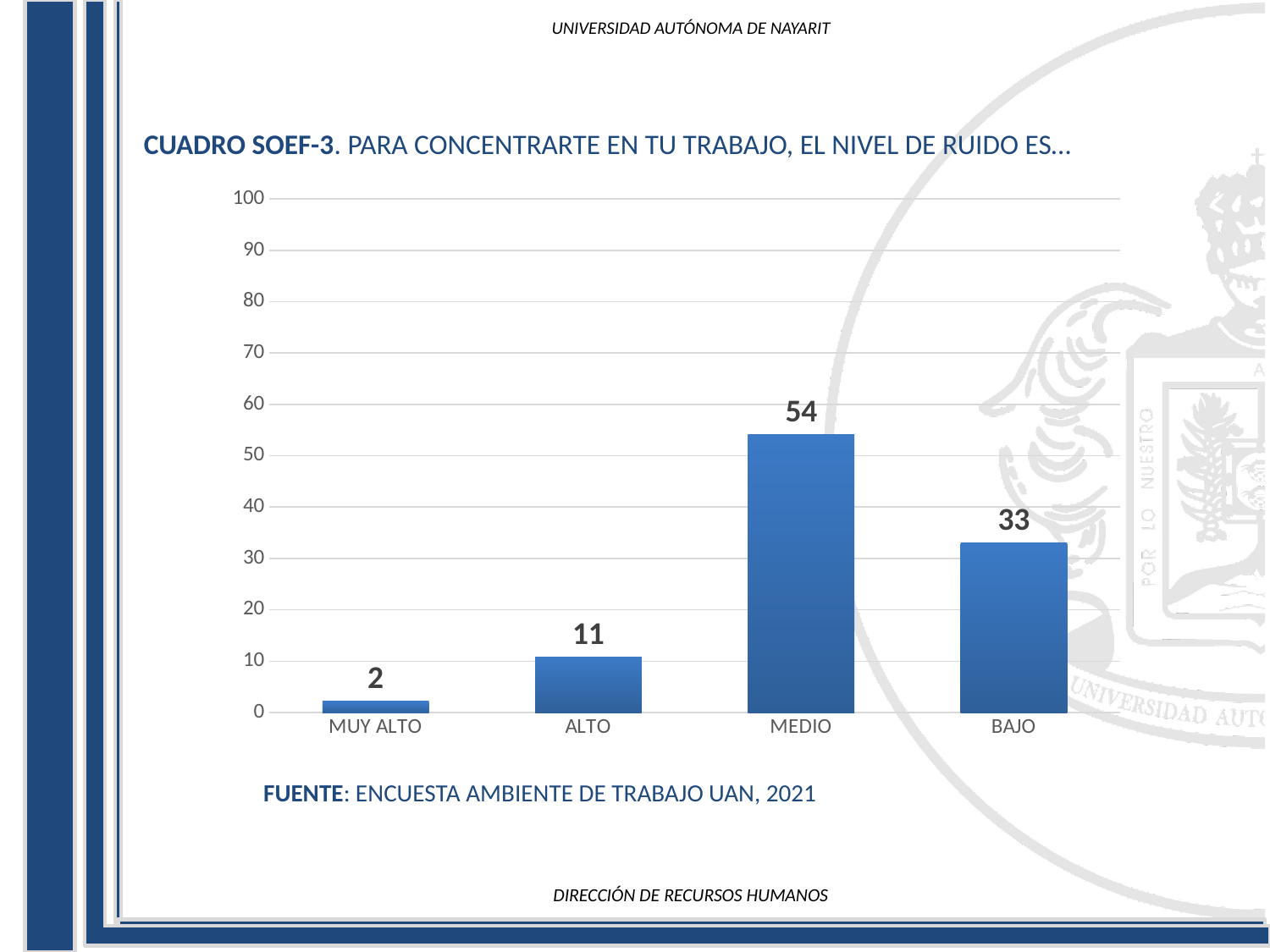
What is the value for ALTO? 11 What is the value for BAJO? 33 Which category has the highest value? MEDIO What is the difference between the values for MEDIO and BAJO? 21 How many categories are shown on the x axis? 4 What kind of chart is shown on the slide? bar chart What is the difference between the values for ALTO and MUY ALTO? 9 What is the value for MUY ALTO? 2 Which is larger, the value for ALTO or the value for BAJO? BAJO Which category has the lowest value? MUY ALTO What is the source cited below the chart? ENCUESTA AMBIENTE DE TRABAJO UAN, 2021 What is the value for MEDIO? 54